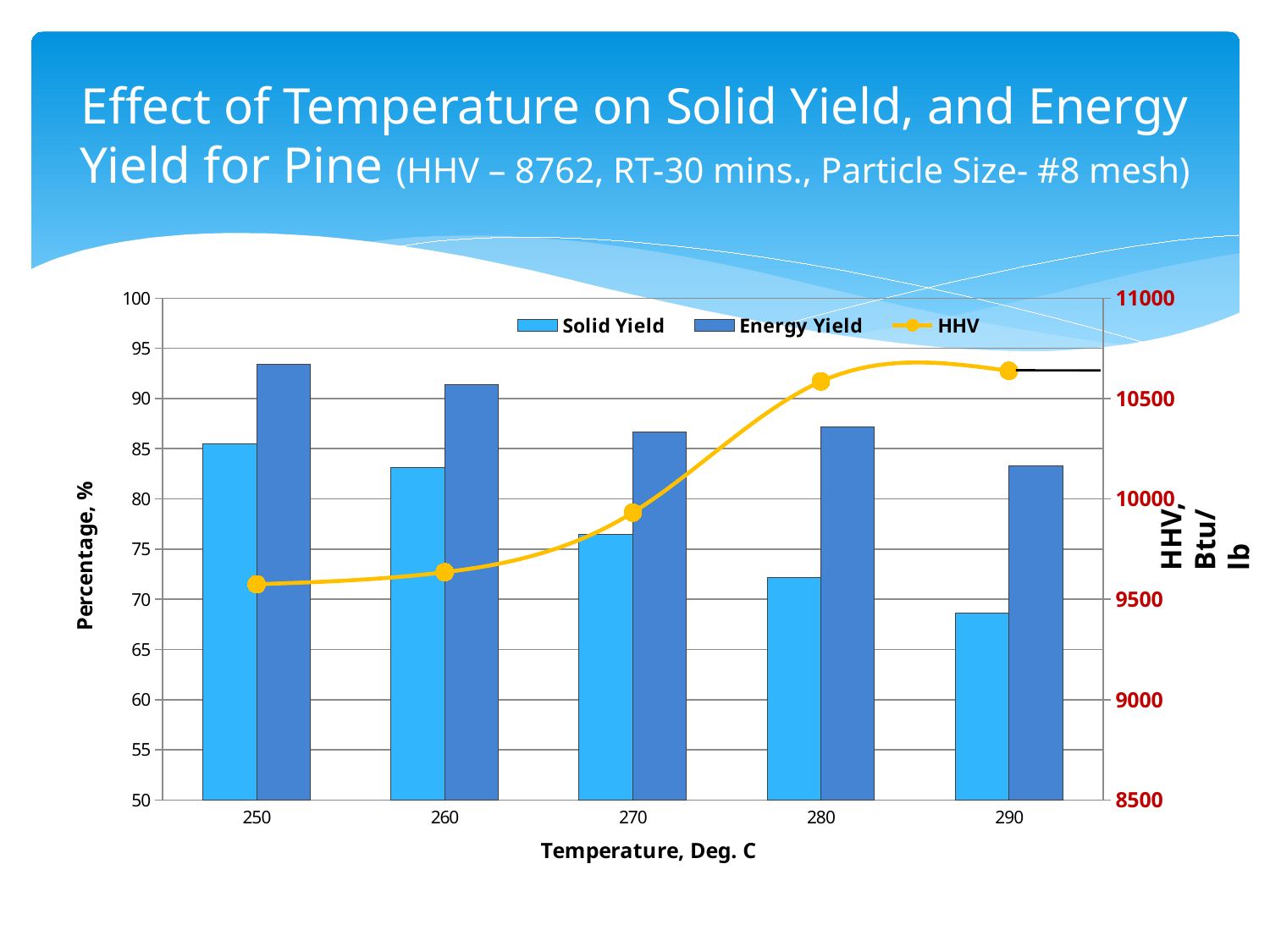
How many series does the legend list? 3 At which temperature is the Energy Yield highest? 250 At which temperature is the Energy Yield lowest? 290 At which temperature is the Solid Yield lowest? 290 Is the Solid Yield at 290 Deg. C greater or less than 70%? less Is the Energy Yield at 250 Deg. C greater or less than 90%? greater At which temperature is the Solid Yield highest? 250 How many temperature categories are plotted on the x axis? 5 Which series is plotted as a line with markers rather than bars? HHV Is the HHV at 280 Deg. C greater or less than 10500 Btu/lb? greater What kind of chart is shown on the slide? A combined bar and line chart Does the Solid Yield rise or fall as temperature increases from 250 to 290 Deg. C? fall